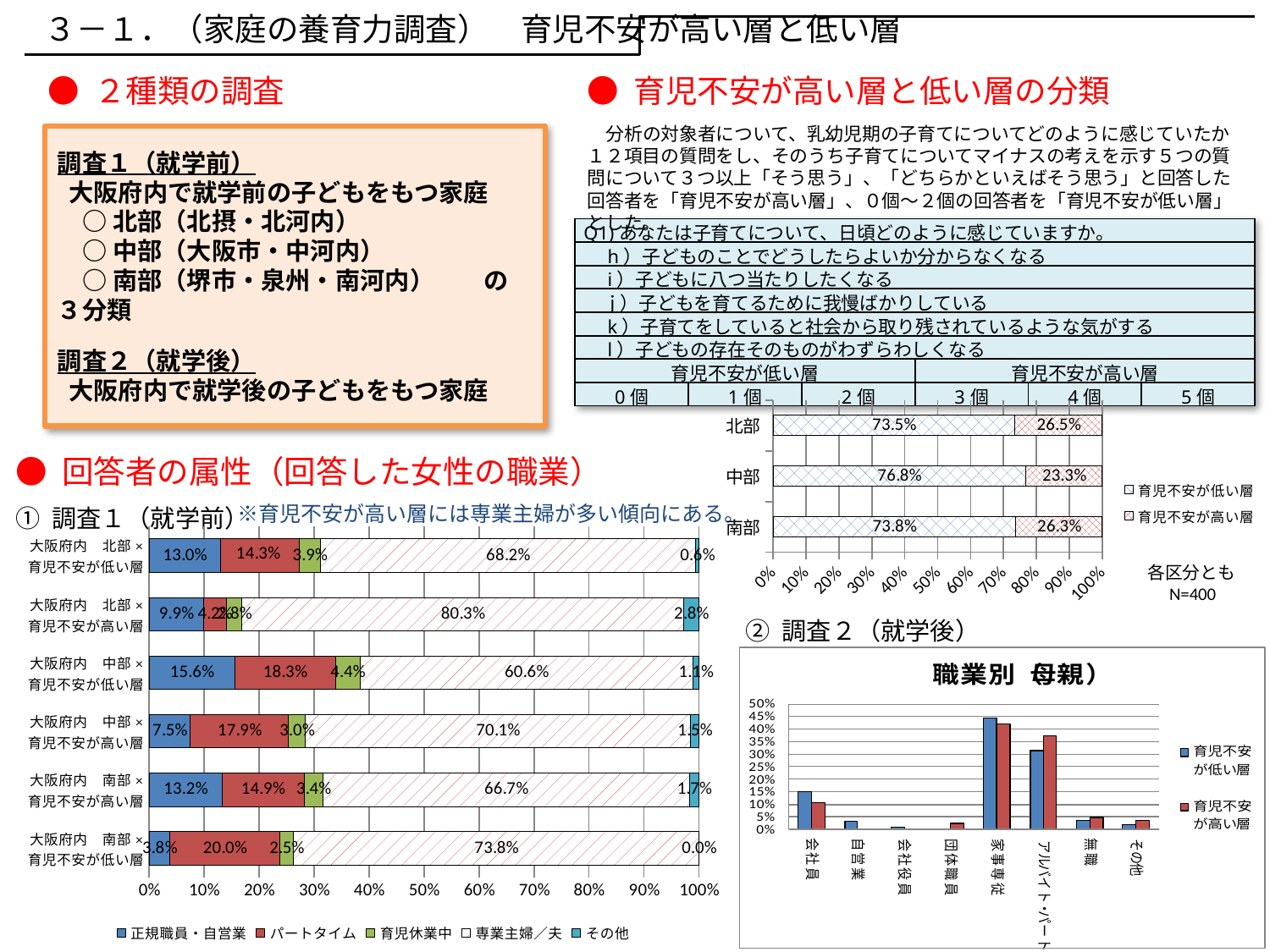
In the top-right chart showing 育児不安が低い層 and 育児不安が高い層 by region, what is the value for 育児不安が低い層 in 北部? 73.5% In the bottom-right chart titled 職業別 母親）, which occupation has the highest value for 育児不安が低い層? 家事専従 In the top-right chart by region (北部/中部/南部), which region has the highest share of 育児不安が低い層? 中部 In the bottom-left chart (① 調査1 就学前), which category has the highest value for 専業主婦／夫? 大阪府内 北部×育児不安が高い層 How many series does the legend of the bottom-left chart (① 調査1 就学前) list? 5 How many categories are shown in the bottom-left chart (① 調査1 就学前)? 6 In the bottom-left chart (① 調査1 就学前), what is the value for 正規職員・自営業 in the 大阪府内 中部×育児不安が低い層 category? 15.6% How many series does the legend of the top-right chart by region list? 2 In the bottom-right chart titled 職業別 母親）, is the value for 家事専従 in the 育児不安が低い層 series greater or less than 40%? greater In the top-right chart by region, what is the value for 育児不安が高い層 in 中部? 23.3% In the bottom-left chart (① 調査1 就学前), what is the difference in 専業主婦／夫 between 大阪府内 北部×育児不安が高い層 and 大阪府内 北部×育児不安が低い層? 12.1% In the bottom-left chart (① 調査1 就学前), what is the value for 専業主婦／夫 in the 大阪府内 北部×育児不安が高い層 category? 80.3%